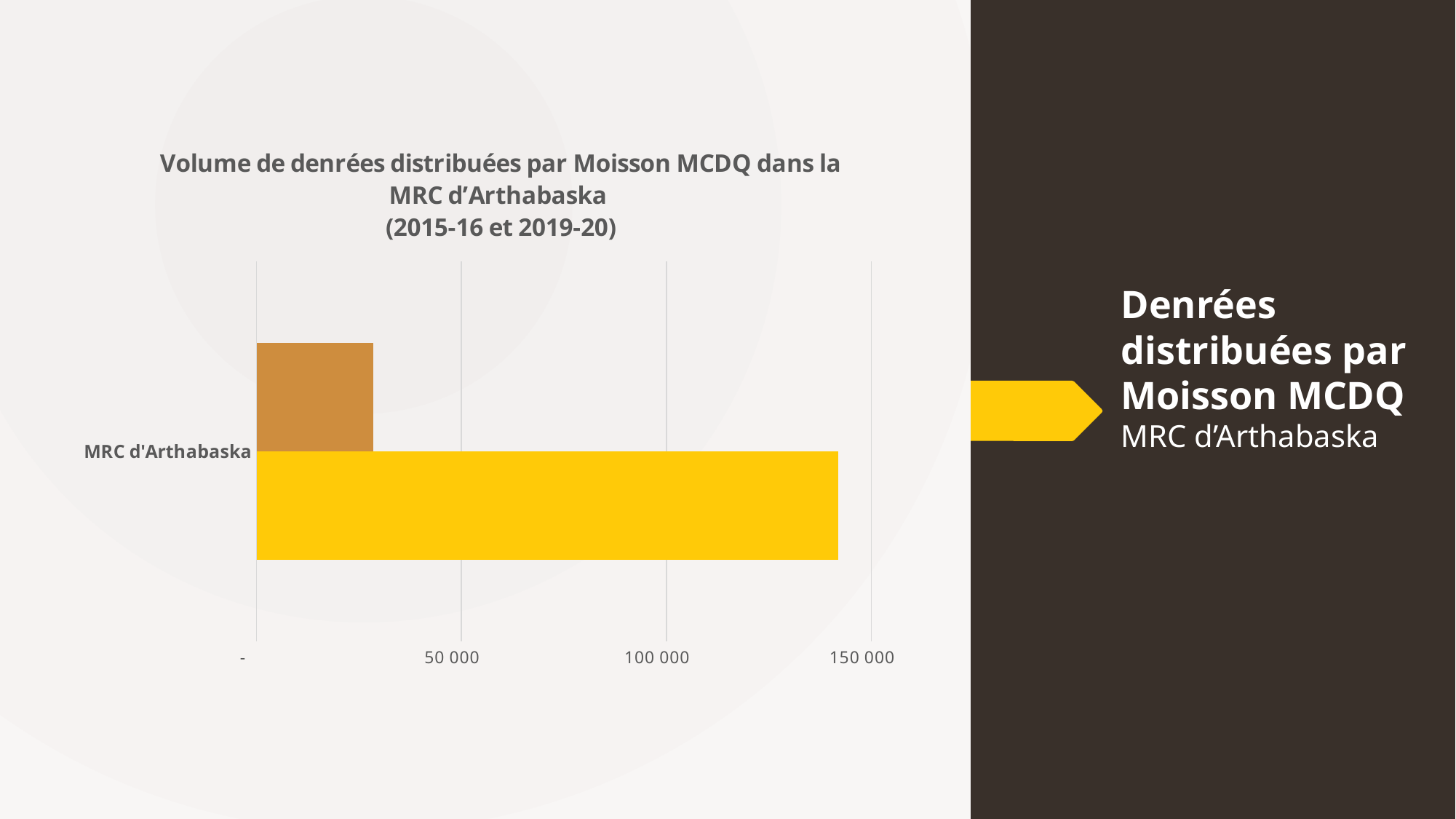
Is the value of the yellow bar for MRC d'Arthabaska greater or less than 150 000? less How many bars are plotted for MRC d'Arthabaska? 2 What is the title of the chart? Volume de denrées distribuées par Moisson MCDQ dans la MRC d'Arthabaska (2015-16 et 2019-20) Is the value of the yellow bar for MRC d'Arthabaska greater or less than 100 000? greater Which bar for MRC d'Arthabaska is longer, the yellow bar or the brown bar? the yellow bar What is the name of the category shown on the chart's vertical axis? MRC d'Arthabaska Is the value of the brown bar for MRC d'Arthabaska greater or less than 50 000? less What kind of chart is shown on the slide? bar chart What is the highest value shown on the chart's horizontal axis? 150 000 How many categories are shown on the vertical axis of the chart? 1